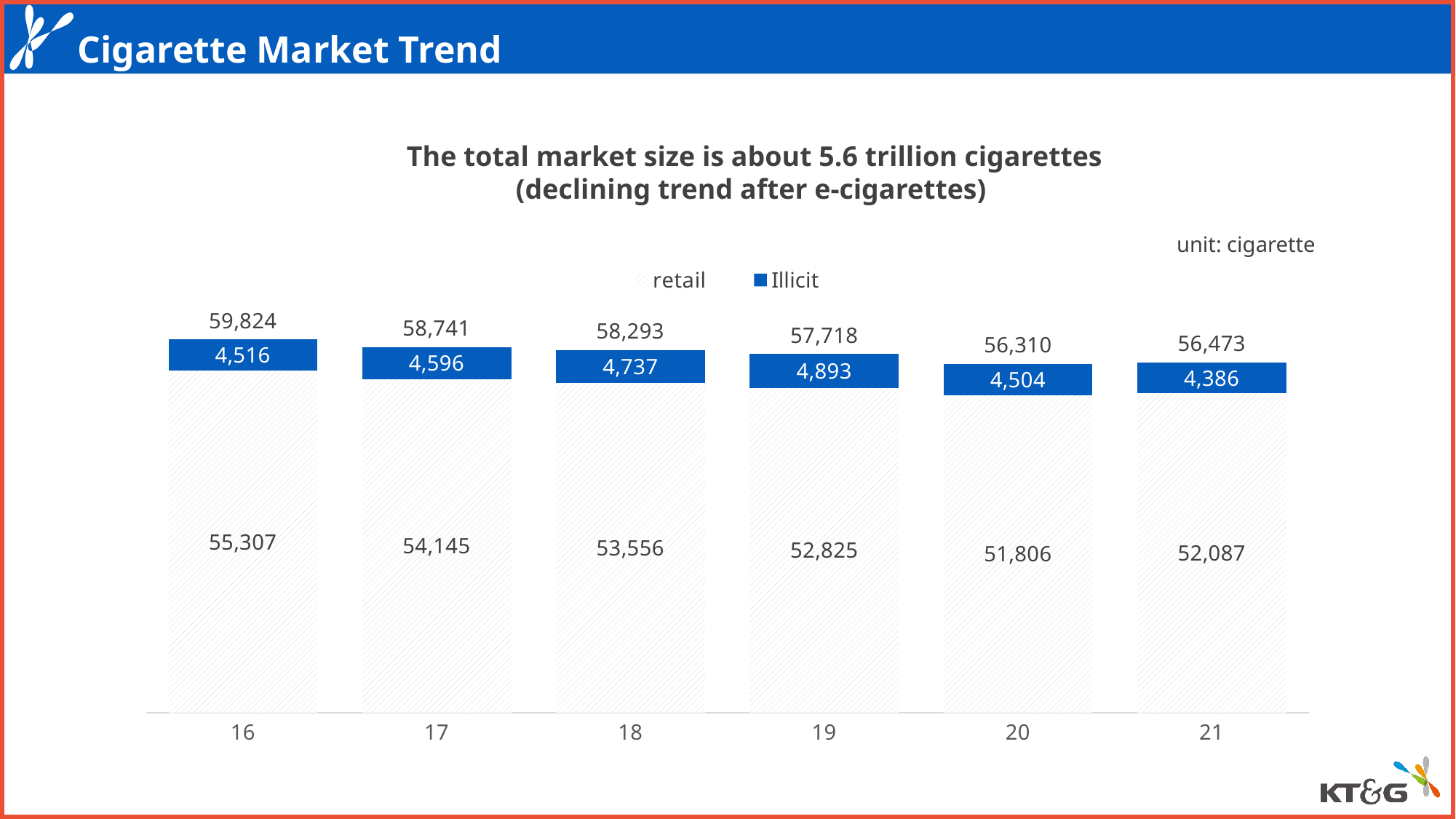
How many years are shown on the x axis? 6 In which year is the Illicit value highest? 19 How many series does the legend list? 2 Does the retail value rise or fall from 16 to 19? Fall What is the difference between the retail value for 16 and the retail value for 21? 3,220 Which is larger, the retail value for 20 or the retail value for 21? 21 What is the Illicit value for 19? 4,893 What is the retail value for 18? 53,556 In which year is the retail value lowest? 20 What kind of chart is shown on the slide? Stacked bar chart What is the difference between the Illicit value for 19 and the Illicit value for 21? 507 What is the total market size shown for 20? 56,310